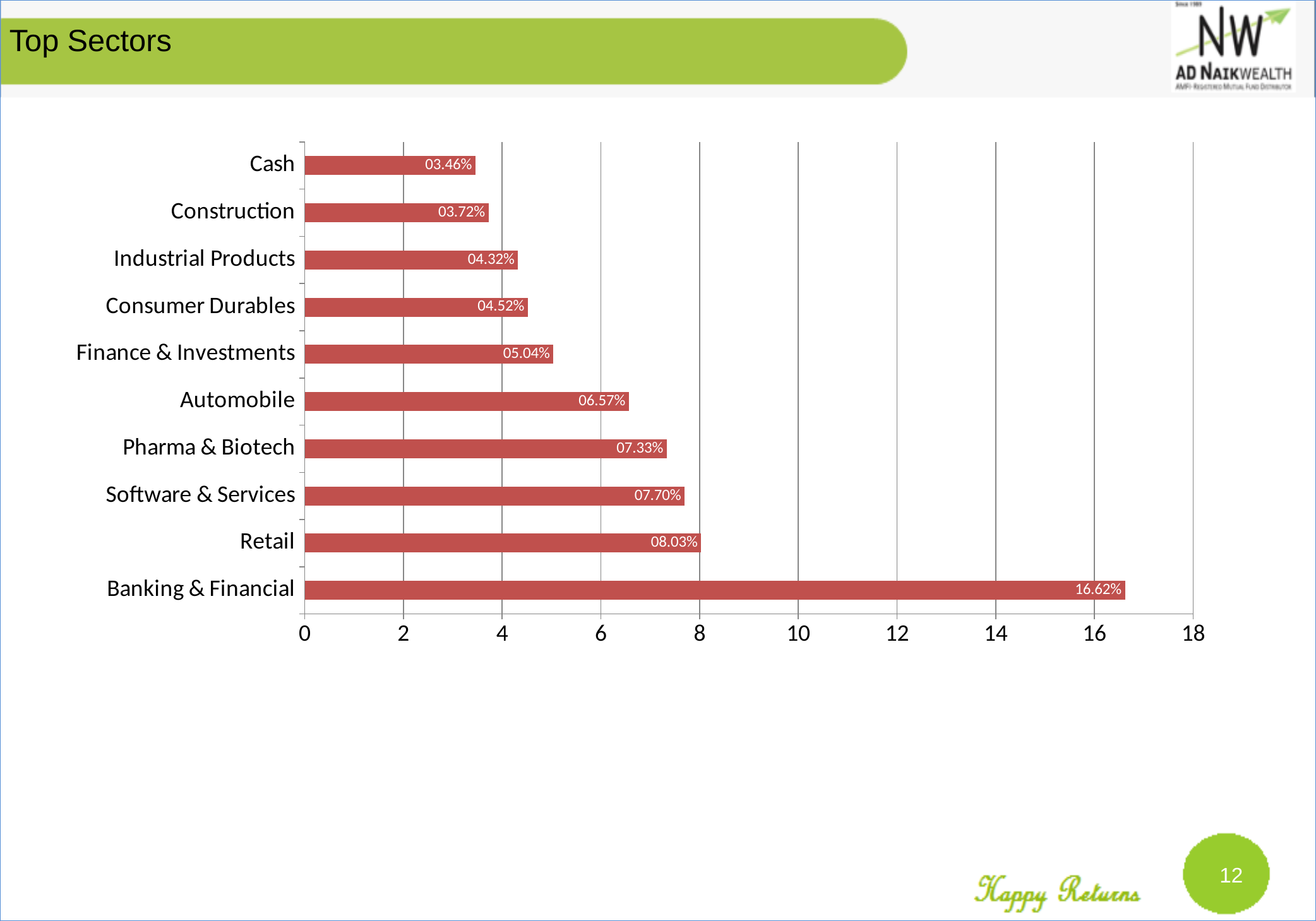
Which sector has the highest value? Banking & Financial Which is larger, the value for Software & Services or the value for Consumer Durables? Software & Services Is the value for Retail greater or less than 6? greater What is the value for Cash? 03.46% What kind of chart is shown on the slide? bar chart Which sector has the lowest value? Cash What is the difference between the values for Banking & Financial and Retail? 8.59% What is the title of the slide? Top Sectors What is the value for Pharma & Biotech? 07.33% What is the value for Banking & Financial? 16.62% What is the difference between the values for Automobile and Finance & Investments? 1.53% How many sectors are shown in the chart? 10